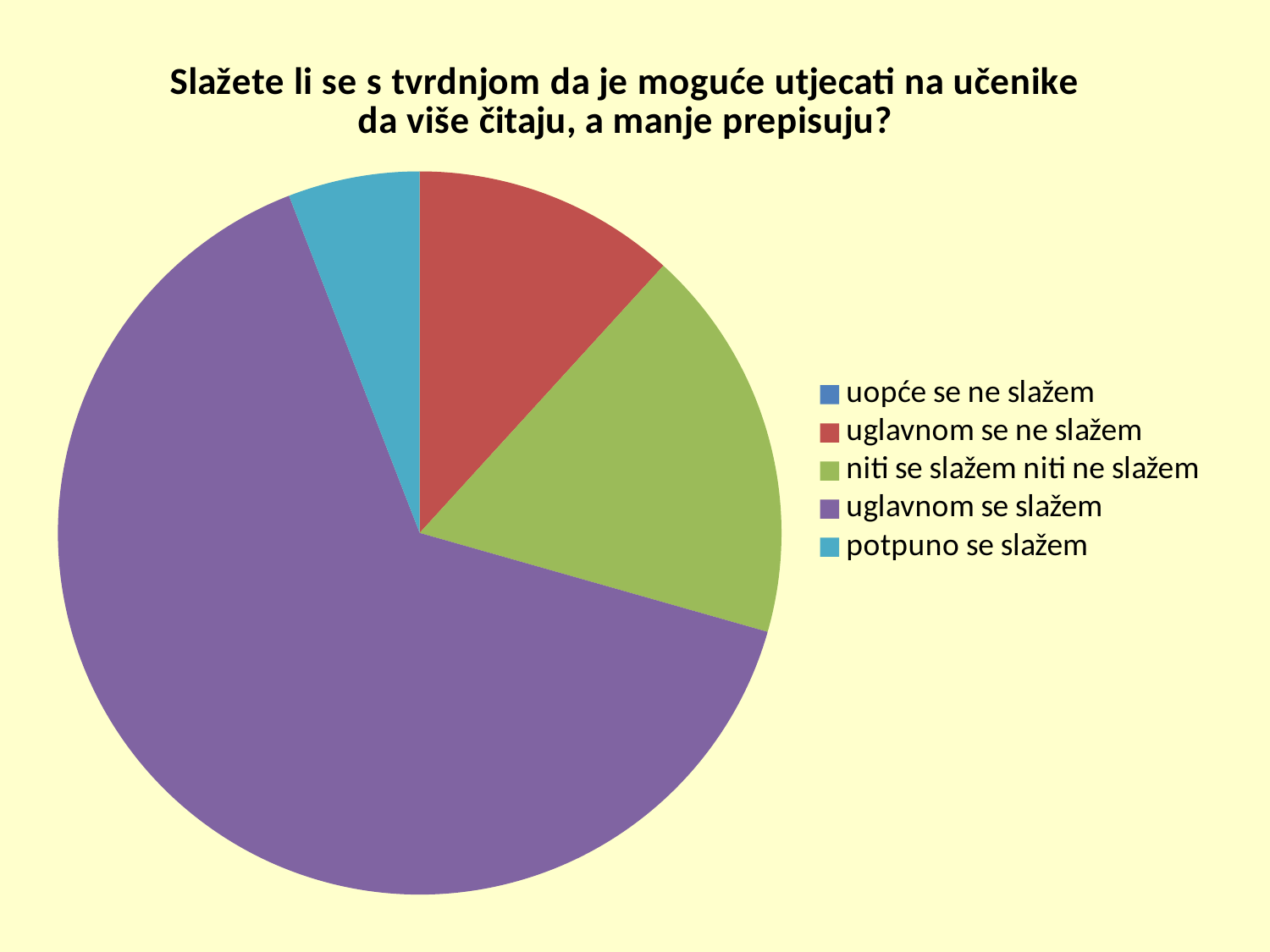
Which slice is larger: "uglavnom se slažem" or "niti se slažem niti ne slažem"? uglavnom se slažem How many slices are visible in the pie? 4 What colour is the slice for "niti se slažem niti ne slažem"? green Which category has the largest slice of the pie? uglavnom se slažem Which slice is smaller: "potpuno se slažem" or "uglavnom se slažem"? potpuno se slažem Which slice is larger: "uglavnom se ne slažem" or "potpuno se slažem"? uglavnom se ne slažem How many entries does the legend list? 5 Does the slice for "uglavnom se slažem" cover more or less than half of the pie? more What is the title of the chart? Slažete li se s tvrdnjom da je moguće utjecati na učenike da više čitaju, a manje prepisuju? What kind of chart is shown on the slide? pie chart